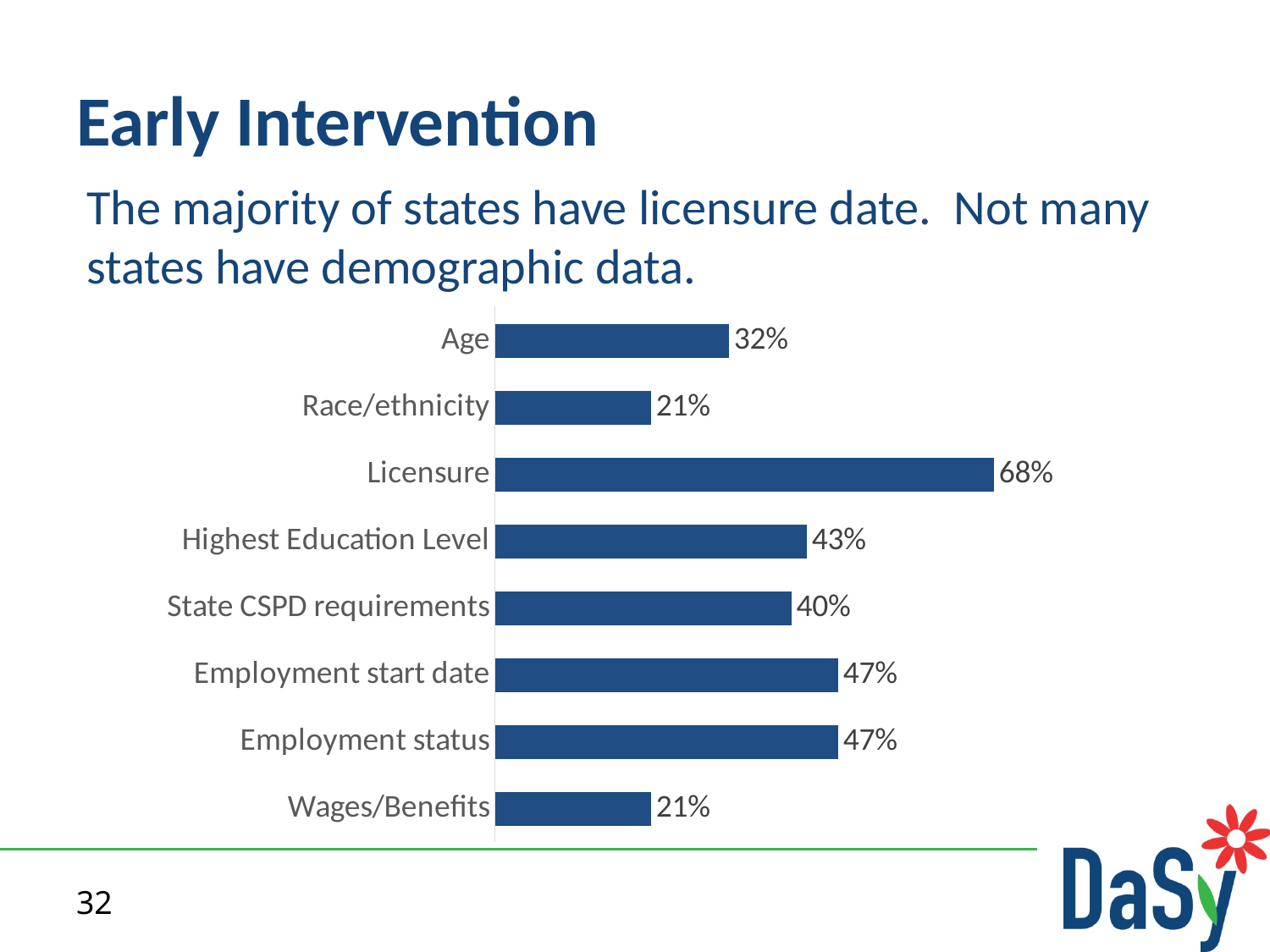
What is the difference between the values for Licensure and Race/ethnicity? 47% What is the value for State CSPD requirements? 40% What is the value for Age? 32% Which is larger, the value for Age or the value for Wages/Benefits? Age What kind of chart is shown on the slide? Bar chart What is the difference between the values for Employment start date and Age? 15% What is the value for Licensure? 68% How many categories are shown in the chart? 8 Which is larger, the value for Highest Education Level or the value for State CSPD requirements? Highest Education Level What is the value for Highest Education Level? 43% Which category has the highest value? Licensure What is the value for Employment status? 47%